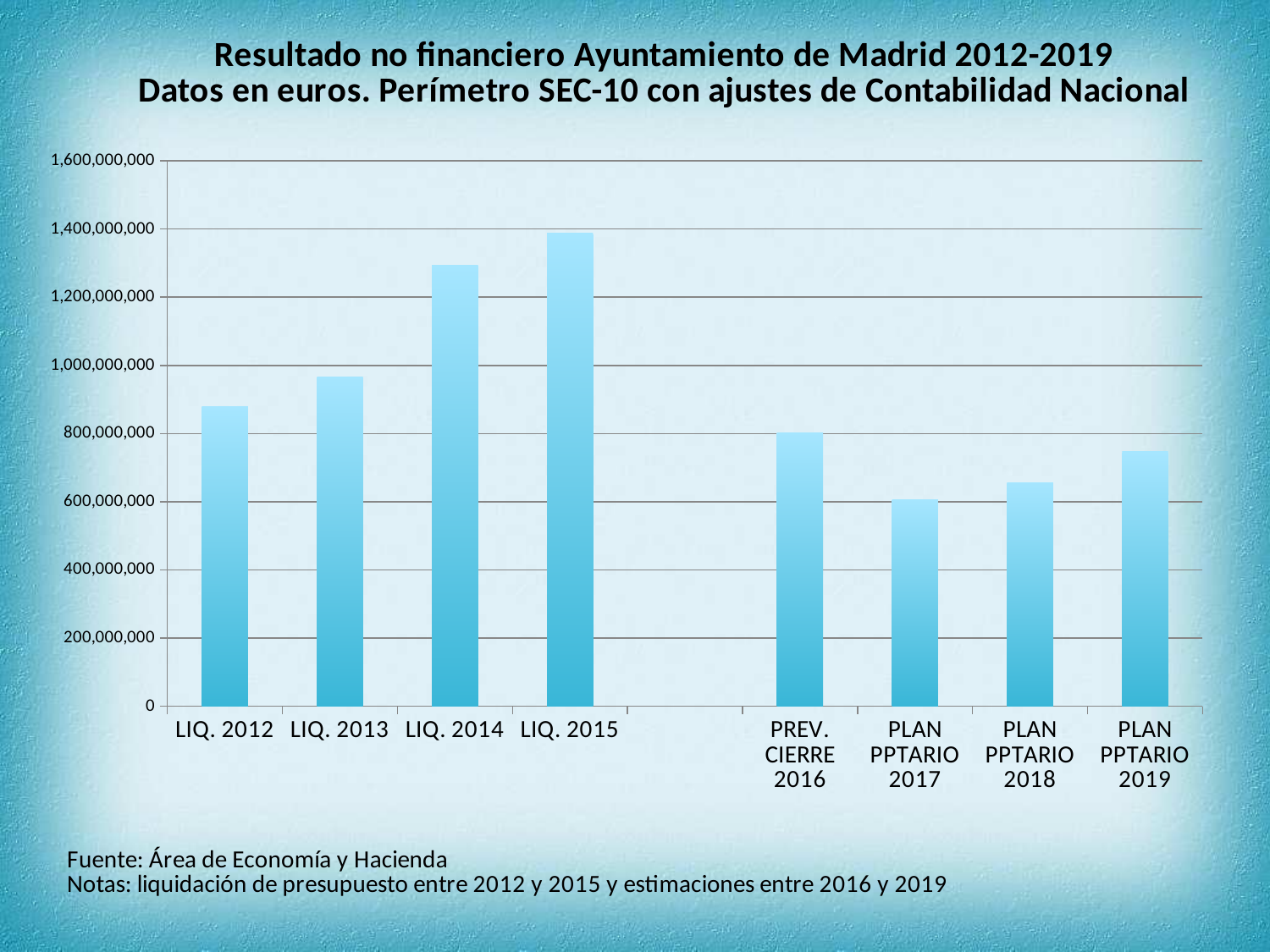
Is the value for LIQ. 2014 greater or less than 1,200,000,000? greater What type of chart is shown on the slide? Bar chart Do the values rise or fall from LIQ. 2012 to LIQ. 2015? rise Is the value for LIQ. 2013 greater or less than 1,000,000,000? less What is the first line of the chart's title? Resultado no financiero Ayuntamiento de Madrid 2012-2019 Is the value for LIQ. 2012 greater or less than 800,000,000? greater Which is larger, the value for LIQ. 2014 or the value for LIQ. 2013? LIQ. 2014 Which category has the lowest value? PLAN PPTARIO 2017 How many bars are plotted in the chart? 8 Which is larger, the value for PREV. CIERRE 2016 or the value for PLAN PPTARIO 2017? PREV. CIERRE 2016 Which category has the highest value? LIQ. 2015